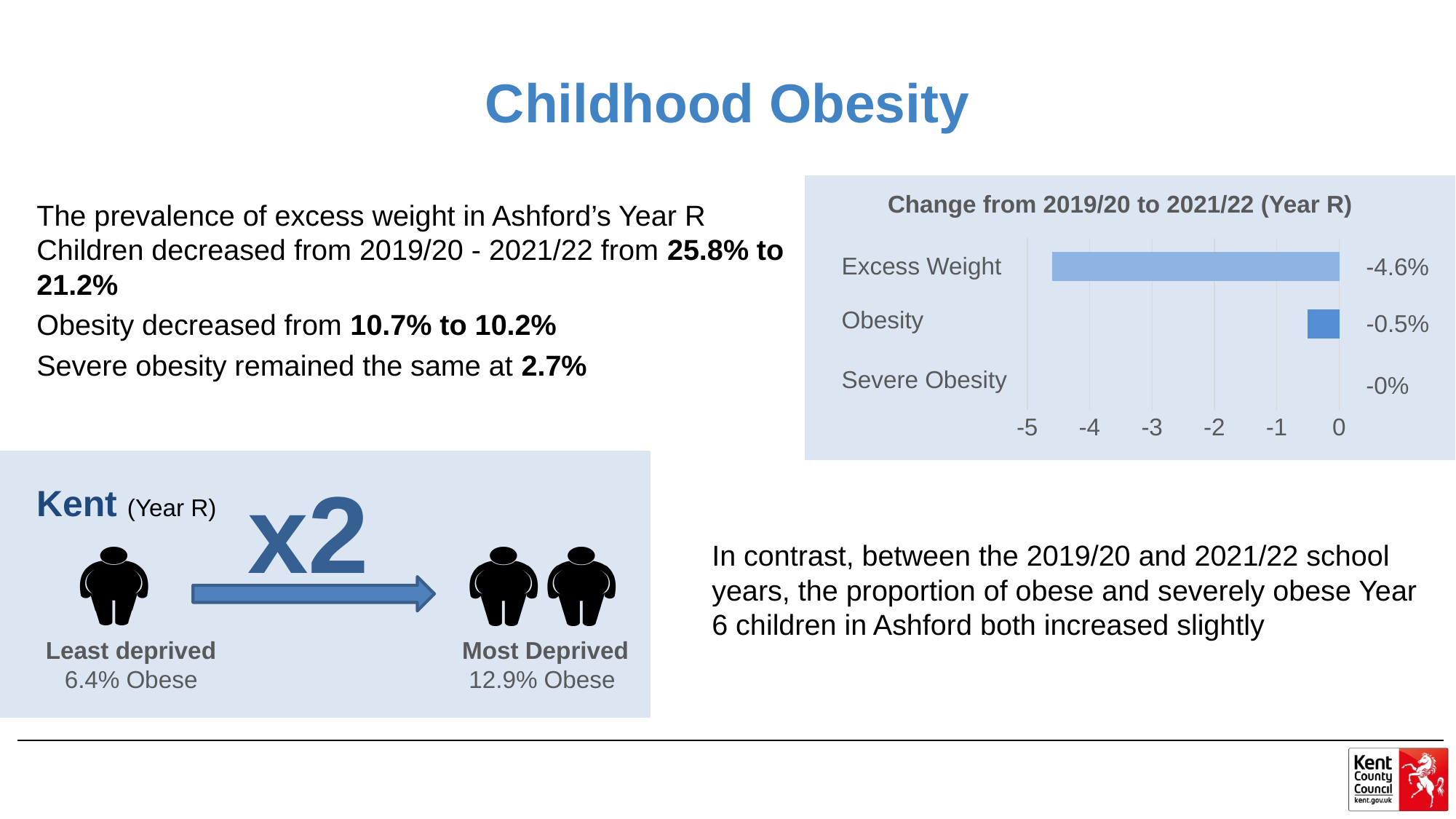
Is the value for Excess Weight in the chart less than -4 or greater than -4? less What is the title of the chart on the slide? Change from 2019/20 to 2021/22 (Year R) What type of chart is shown on the slide? bar chart Which has a larger decrease in the chart, Excess Weight or Obesity? Excess Weight Which category shows the smallest change in the chart? Severe Obesity Which category shows the largest decrease in the chart? Excess Weight How many categories are shown in the chart? 3 What is the value for Obesity in the chart? -0.5% What is the value for Severe Obesity in the chart? -0% What is the difference between the Excess Weight change and the Obesity change in the chart? 4.1 percentage points What is the lowest value shown on the horizontal axis of the chart? -5 What is the value for Excess Weight in the chart? -4.6%